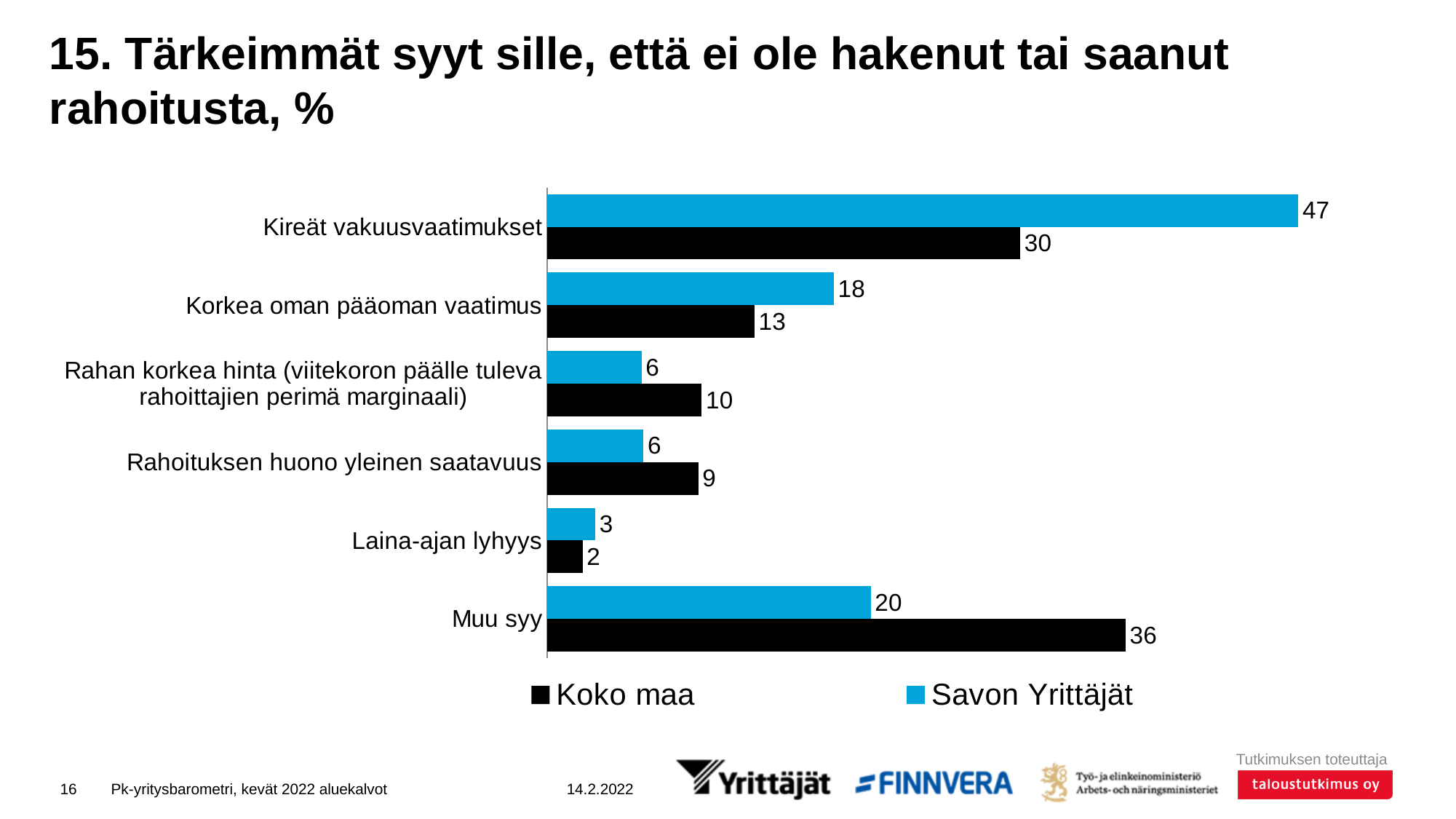
What is the value for Savon Yrittäjät for Kireät vakuusvaatimukset? 47 What is the value for Savon Yrittäjät for Laina-ajan lyhyys? 3 How many series does the legend list? 2 What is the difference between the Savon Yrittäjät and Koko maa values for Kireät vakuusvaatimukset? 17 Which category has the lowest value for Koko maa? Laina-ajan lyhyys What is the value for Koko maa for Korkea oman pääoman vaatimus? 13 Which category has the highest value for Savon Yrittäjät? Kireät vakuusvaatimukset For Muu syy, which series has the larger value, Koko maa or Savon Yrittäjät? Koko maa How many categories are shown on the chart? 6 What is the value for Koko maa for Muu syy? 36 Which colour represents Savon Yrittäjät in the chart? Blue What kind of chart is shown on the slide? Bar chart